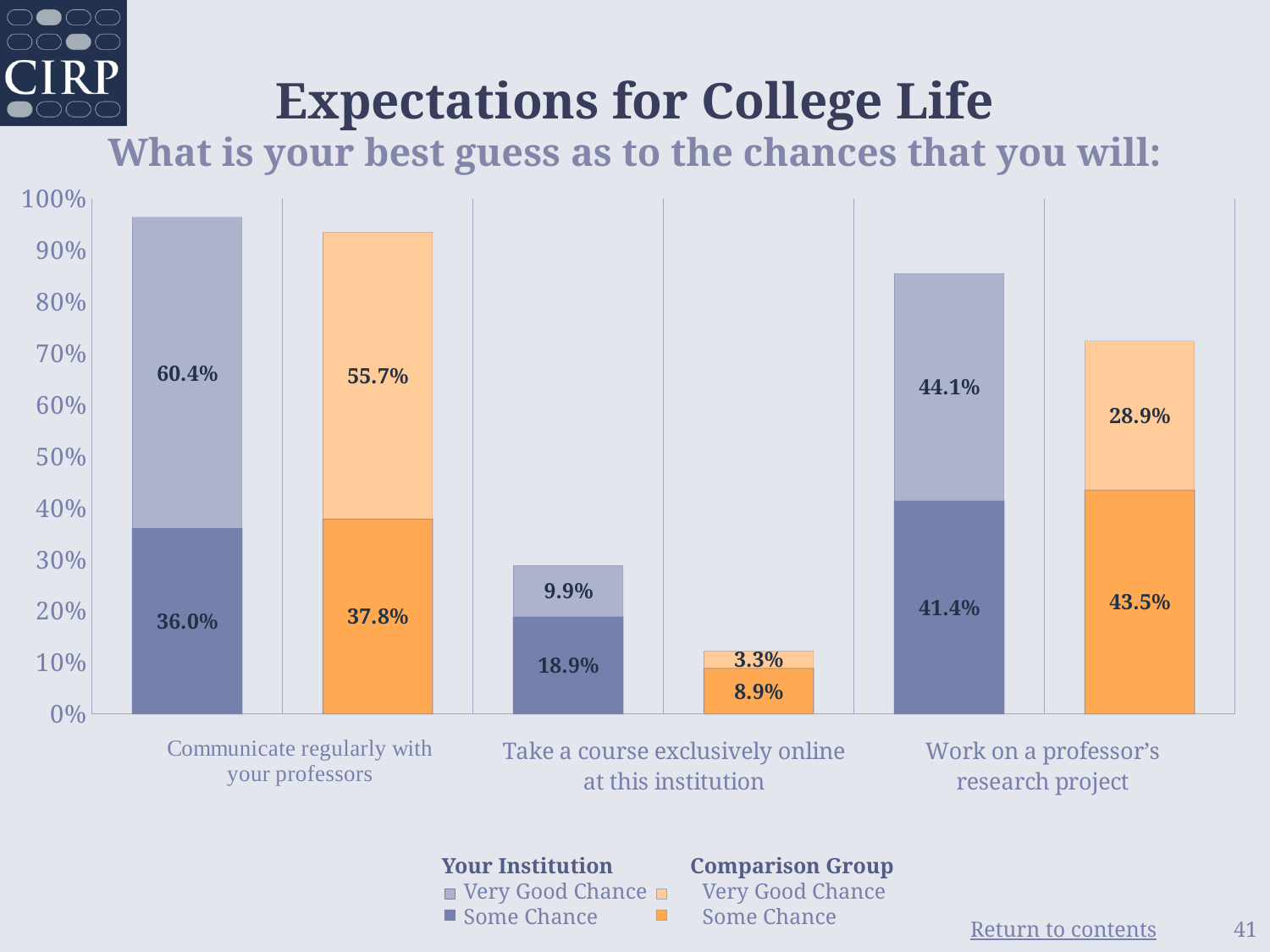
What is the difference between the Your Institution and Comparison Group 'Very Good Chance' values for 'Work on a professor's research project'? 15.2% How many categories are shown on the x axis? 3 What is the 'Very Good Chance' value for Your Institution for 'Communicate regularly with your professors'? 60.4% For 'Communicate regularly with your professors', which is larger: the Your Institution 'Very Good Chance' value or the Comparison Group 'Very Good Chance' value? Your Institution What is the total of the Your Institution stacked bar for 'Take a course exclusively online at this institution'? 28.8% Which category has the lowest 'Very Good Chance' value for the Comparison Group? Take a course exclusively online at this institution What kind of chart is shown on the slide? Stacked bar chart What is the 'Some Chance' value for the Comparison Group for 'Work on a professor's research project'? 43.5% What is the 'Very Good Chance' value for the Comparison Group for 'Take a course exclusively online at this institution'? 3.3% Which category has the highest 'Some Chance' value for Your Institution? Work on a professor's research project What is the total of the Comparison Group stacked bar for 'Work on a professor's research project'? 72.4% How many series does the legend list? 4